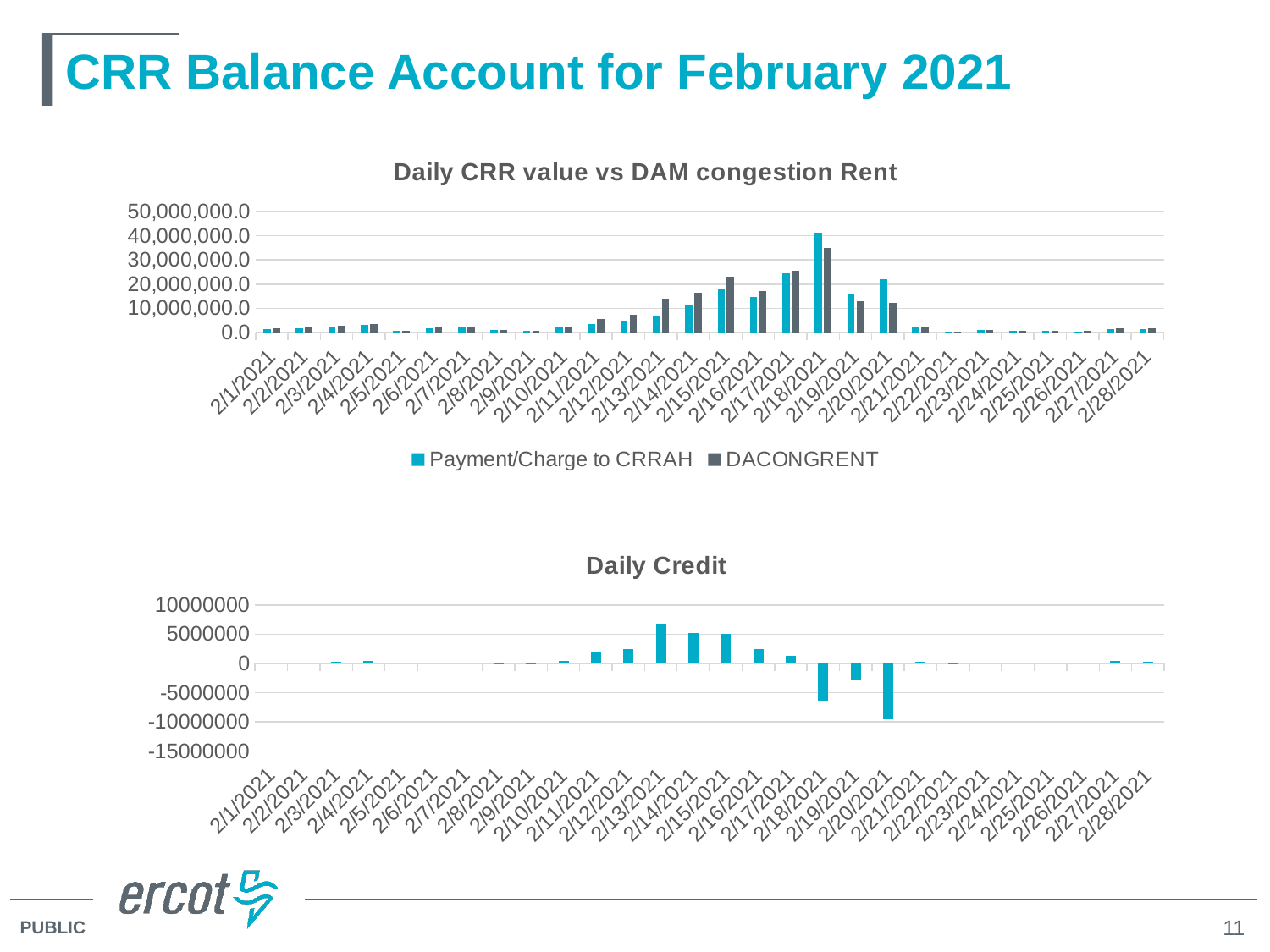
How many dates are plotted on the x axis of the 'Daily Credit' chart? 28 In the 'Daily CRR value vs DAM congestion Rent' chart, what are the two series named in the legend? Payment/Charge to CRRAH and DACONGRENT In the 'Daily Credit' chart, on which date is the value highest? 2/13/2021 In the 'Daily Credit' chart, on which date is the value lowest? 2/20/2021 In the 'Daily CRR value vs DAM congestion Rent' chart, on 2/18/2021, which is larger: Payment/Charge to CRRAH or DACONGRENT? Payment/Charge to CRRAH In the 'Daily CRR value vs DAM congestion Rent' chart, is the Payment/Charge to CRRAH value for 2/18/2021 greater or less than 30,000,000.0? greater What kind of chart is the 'Daily Credit' chart? Bar chart In the 'Daily CRR value vs DAM congestion Rent' chart, is the Payment/Charge to CRRAH value for 2/17/2021 greater or less than 30,000,000.0? less In the 'Daily CRR value vs DAM congestion Rent' chart, on 2/15/2021, which is larger: Payment/Charge to CRRAH or DACONGRENT? DACONGRENT In the 'Daily CRR value vs DAM congestion Rent' chart, on which date is the Payment/Charge to CRRAH value highest? 2/18/2021 In the 'Daily CRR value vs DAM congestion Rent' chart, on which date is the DACONGRENT value highest? 2/18/2021 In the 'Daily CRR value vs DAM congestion Rent' chart, how many series does the legend list? 2